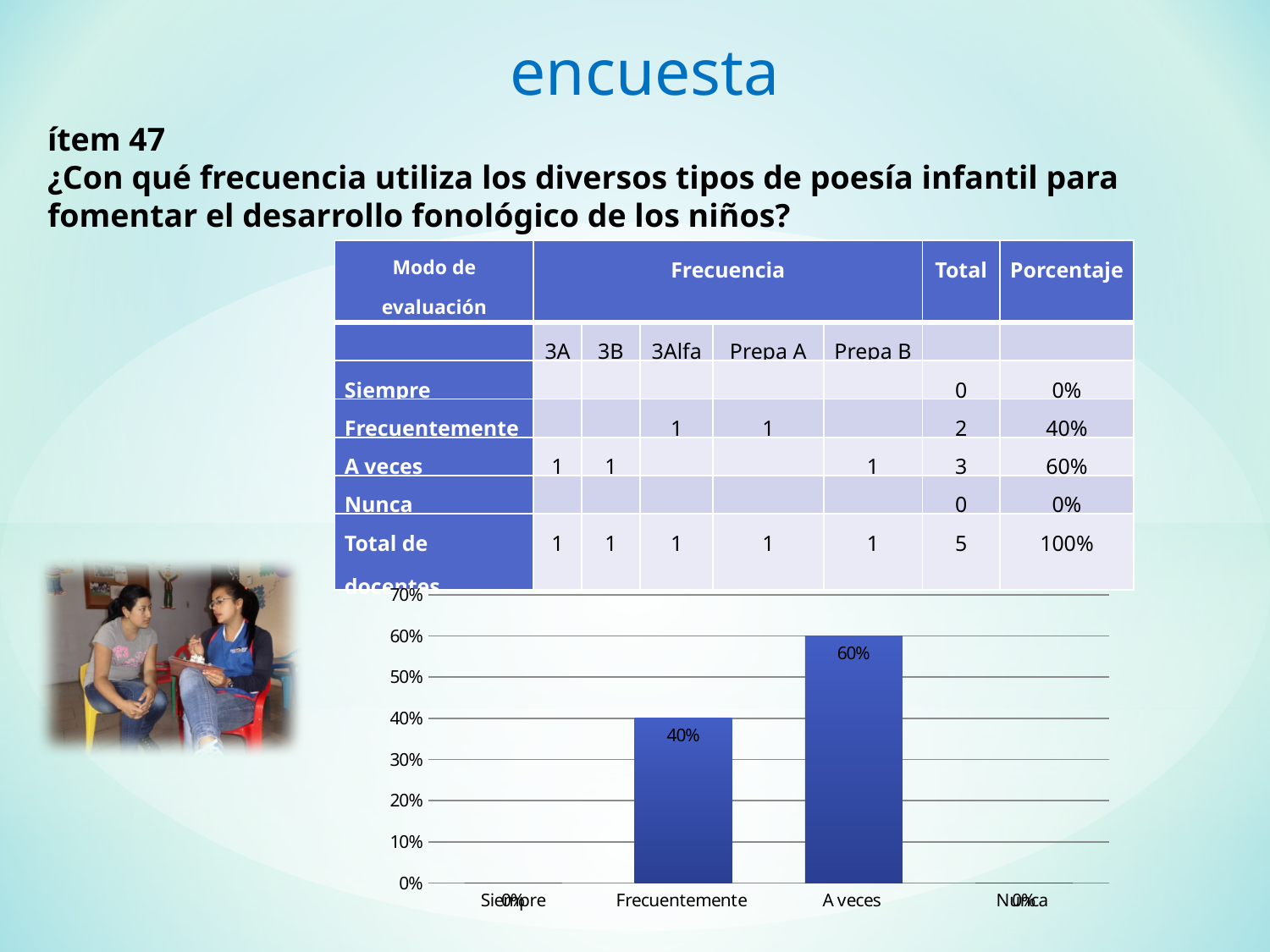
What is the value for Frecuentemente in the chart? 40% What is the value for Nunca in the chart? 0% What is the highest tick value shown on the y axis of the chart? 70% Which is larger, the value for Frecuentemente or the value for A veces? A veces How many categories are shown on the x axis of the chart? 4 What is the value for A veces in the chart? 60% What type of chart is shown on the slide? bar chart Is the value for Frecuentemente greater or less than 50%? less Is the value for A veces greater or less than 50%? greater What is the value for Siempre in the chart? 0% Which category has the highest value in the chart? A veces What is the difference between the values for A veces and Frecuentemente? 20%